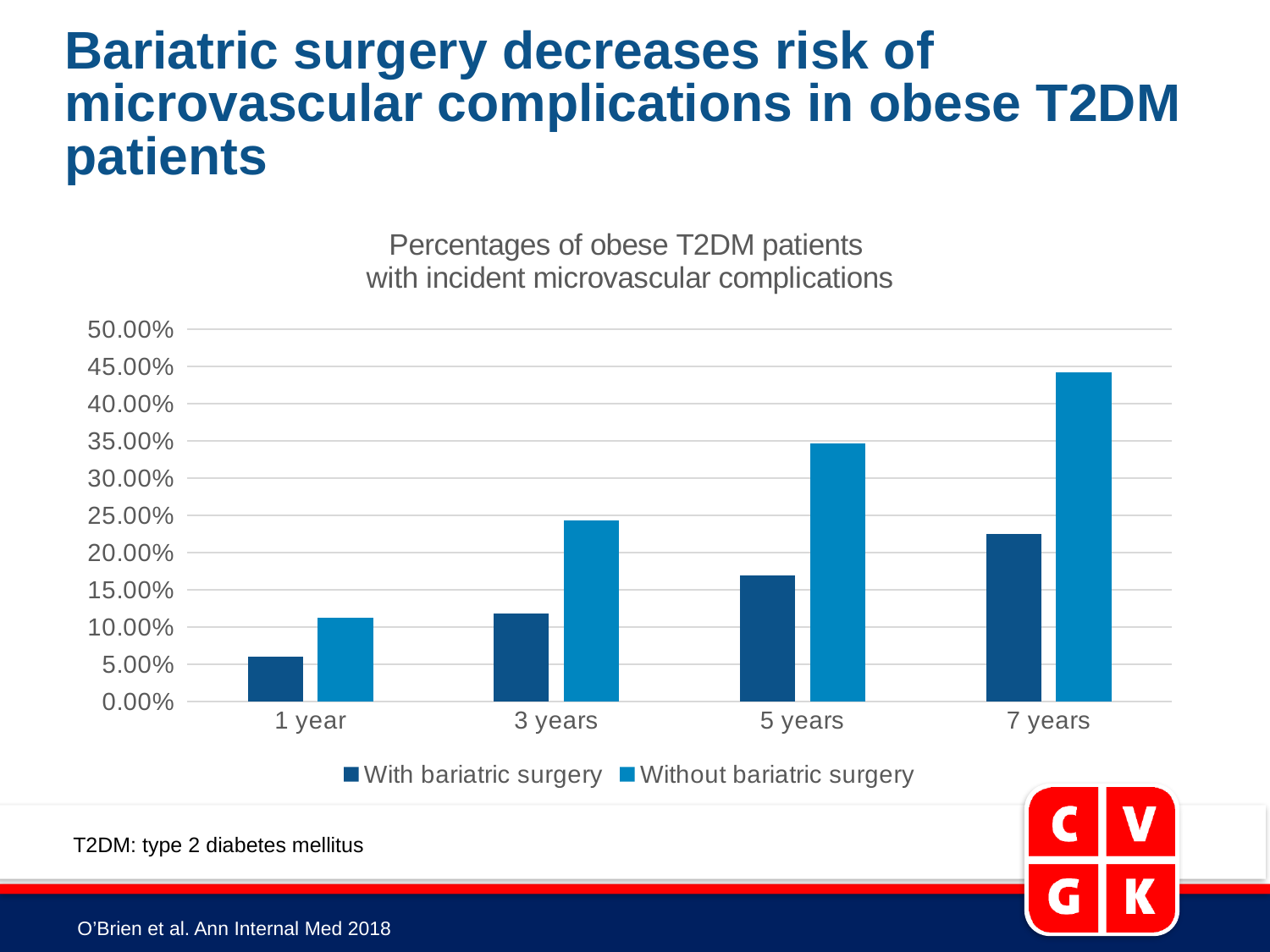
Which category has the highest value for 'Without bariatric surgery'? 7 years Do the values for 'With bariatric surgery' rise or fall from 1 year to 7 years? rise Is the value for 'With bariatric surgery' at 1 year greater or less than 10.00%? less Is the value for 'With bariatric surgery' at 5 years greater or less than 20.00%? less What kind of chart is shown on the slide? bar chart How many series does the legend list? 2 Is the value for 'Without bariatric surgery' at 5 years greater or less than 30.00%? greater Which category has the lowest value for 'With bariatric surgery'? 1 year At 5 years, which is larger: the value with bariatric surgery or without bariatric surgery? Without bariatric surgery How many time-point categories are shown on the x axis? 4 What is the title of the chart? Percentages of obese T2DM patients with incident microvascular complications